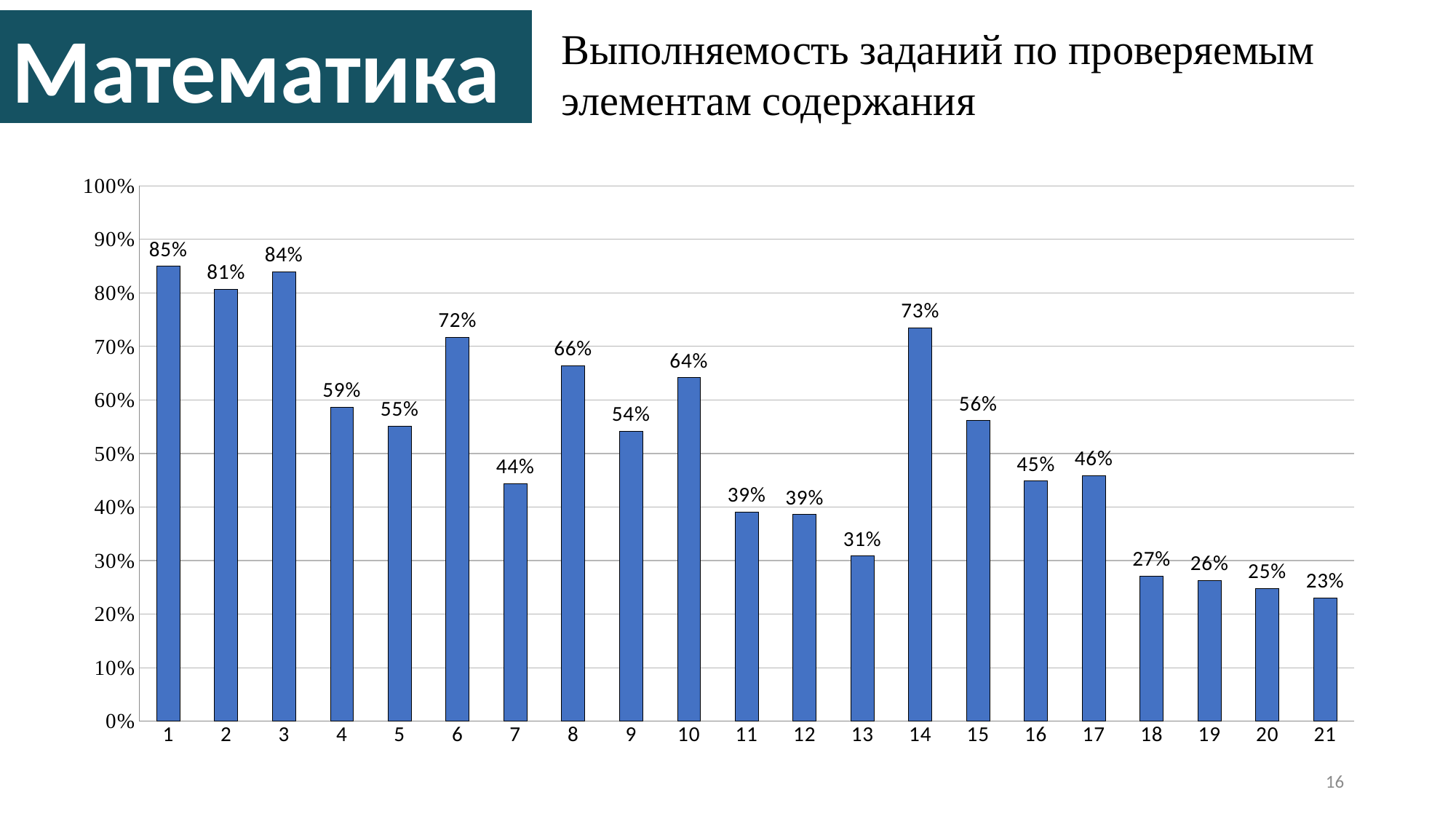
Which is larger, the value for category 10 or the value for category 15? 10 Which category has the highest value? 1 Is the value for category 13 greater or less than 40%? less What is the value for category 6? 72% What is the title of the slide above the chart? Выполняемость заданий по проверяемым элементам содержания What is the value for category 21? 23% Which category has the lowest value? 21 What kind of chart is shown on the slide? bar chart What is the difference between the values for category 4 and category 5? 4% What is the difference between the values for category 1 and category 21? 62% What is the value for category 14? 73% How many categories are shown on the x axis? 21